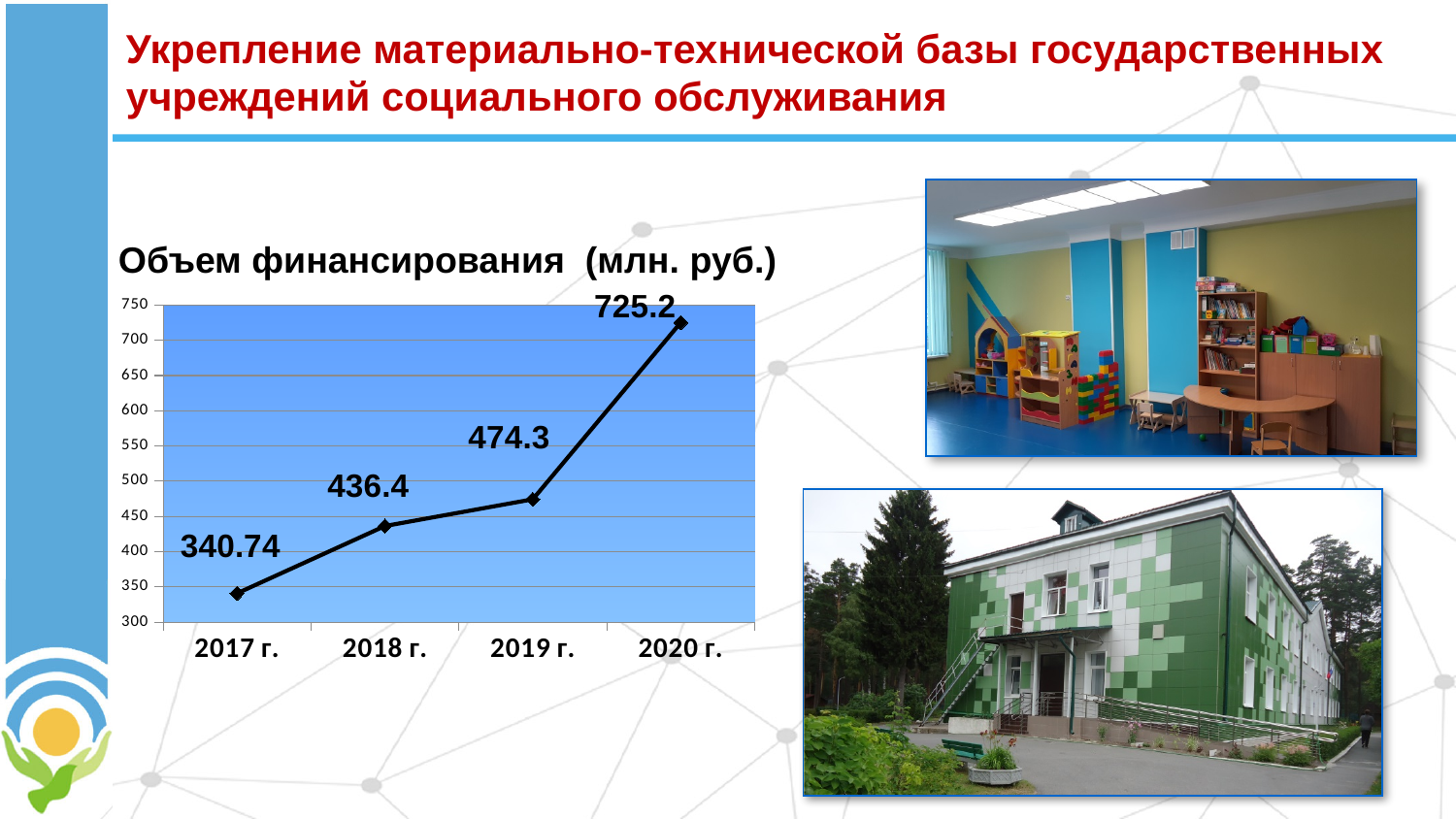
How many years are plotted on the chart? 4 Which year has the highest value? 2020 г. Which is larger, the value for 2018 г. or the value for 2019 г.? 2019 г. Which year has the lowest value? 2017 г. What kind of chart is shown on the slide? line chart What is the value for 2018 г.? 436.4 What is the difference between the values for 2019 г. and 2018 г.? 37.9 What is the value for 2017 г.? 340.74 Do the values rise or fall from 2017 г. to 2020 г.? rise What is the value for 2019 г.? 474.3 What is the value for 2020 г.? 725.2 What is the difference between the values for 2020 г. and 2019 г.? 250.9